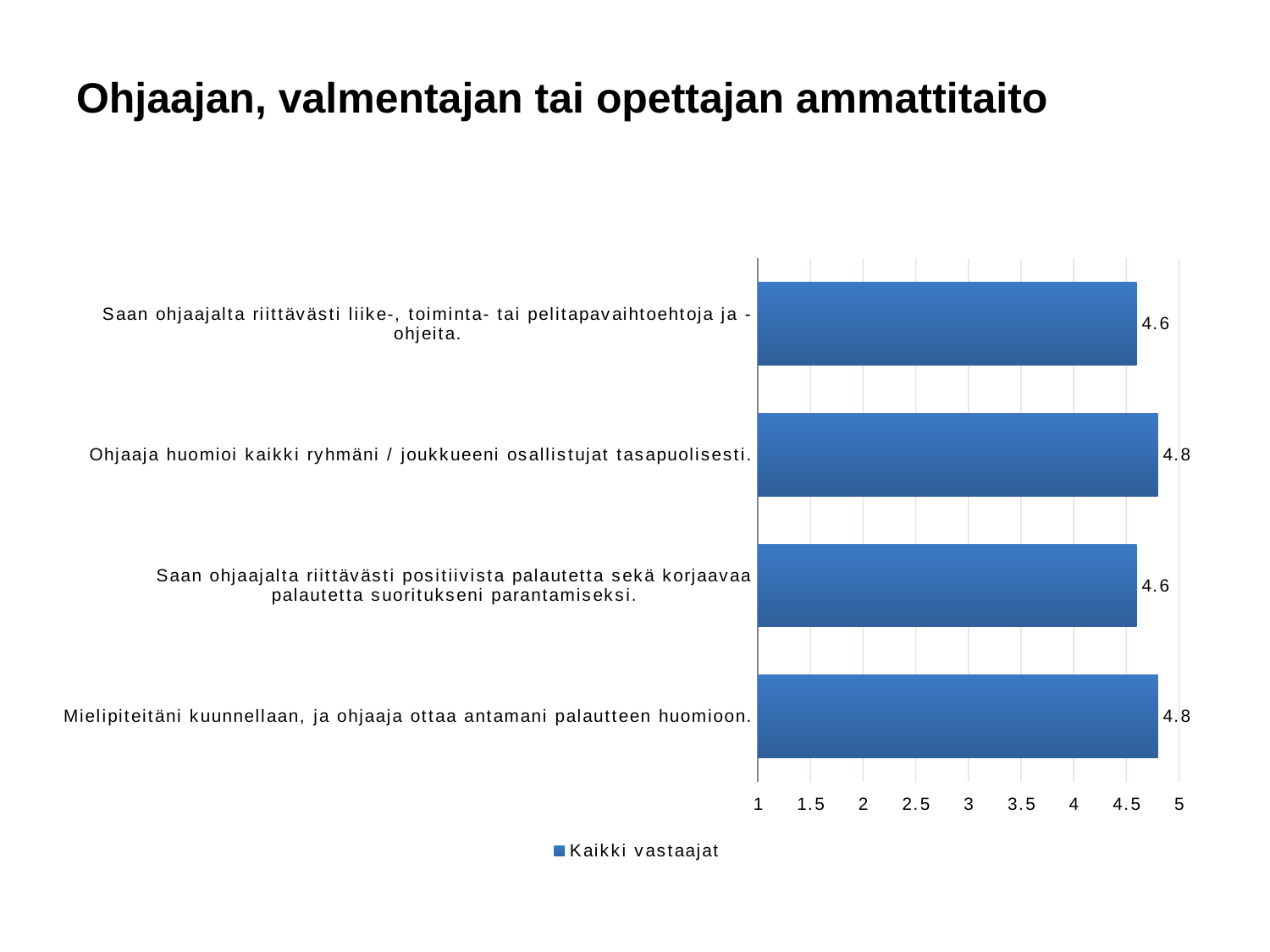
How many categories are shown in the chart? 4 What is the value for "Ohjaaja huomioi kaikki ryhmäni / joukkueeni osallistujat tasapuolisesti."? 4.8 What is the name of the series listed in the legend? Kaikki vastaajat What is the value for "Saan ohjaajalta riittävästi liike-, toiminta- tai pelitapavaihtoehtoja ja -ohjeita."? 4.6 How many series does the legend list? 1 What is the difference between the value for "Ohjaaja huomioi kaikki ryhmäni / joukkueeni osallistujat tasapuolisesti." and the value for "Saan ohjaajalta riittävästi liike-, toiminta- tai pelitapavaihtoehtoja ja -ohjeita."? 0.2 Is the value for "Saan ohjaajalta riittävästi positiivista palautetta sekä korjaavaa palautetta suoritukseni parantamiseksi." greater or less than 4? greater What kind of chart is shown on the slide? bar chart What is the value for "Saan ohjaajalta riittävästi positiivista palautetta sekä korjaavaa palautetta suoritukseni parantamiseksi."? 4.6 What is the value for "Mielipiteitäni kuunnellaan, ja ohjaaja ottaa antamani palautteen huomioon."? 4.8 What is the title of the slide? Ohjaajan, valmentajan tai opettajan ammattitaito Which is larger: the value for "Mielipiteitäni kuunnellaan, ja ohjaaja ottaa antamani palautteen huomioon." or the value for "Saan ohjaajalta riittävästi positiivista palautetta sekä korjaavaa palautetta suoritukseni parantamiseksi."? Mielipiteitäni kuunnellaan, ja ohjaaja ottaa antamani palautteen huomioon.